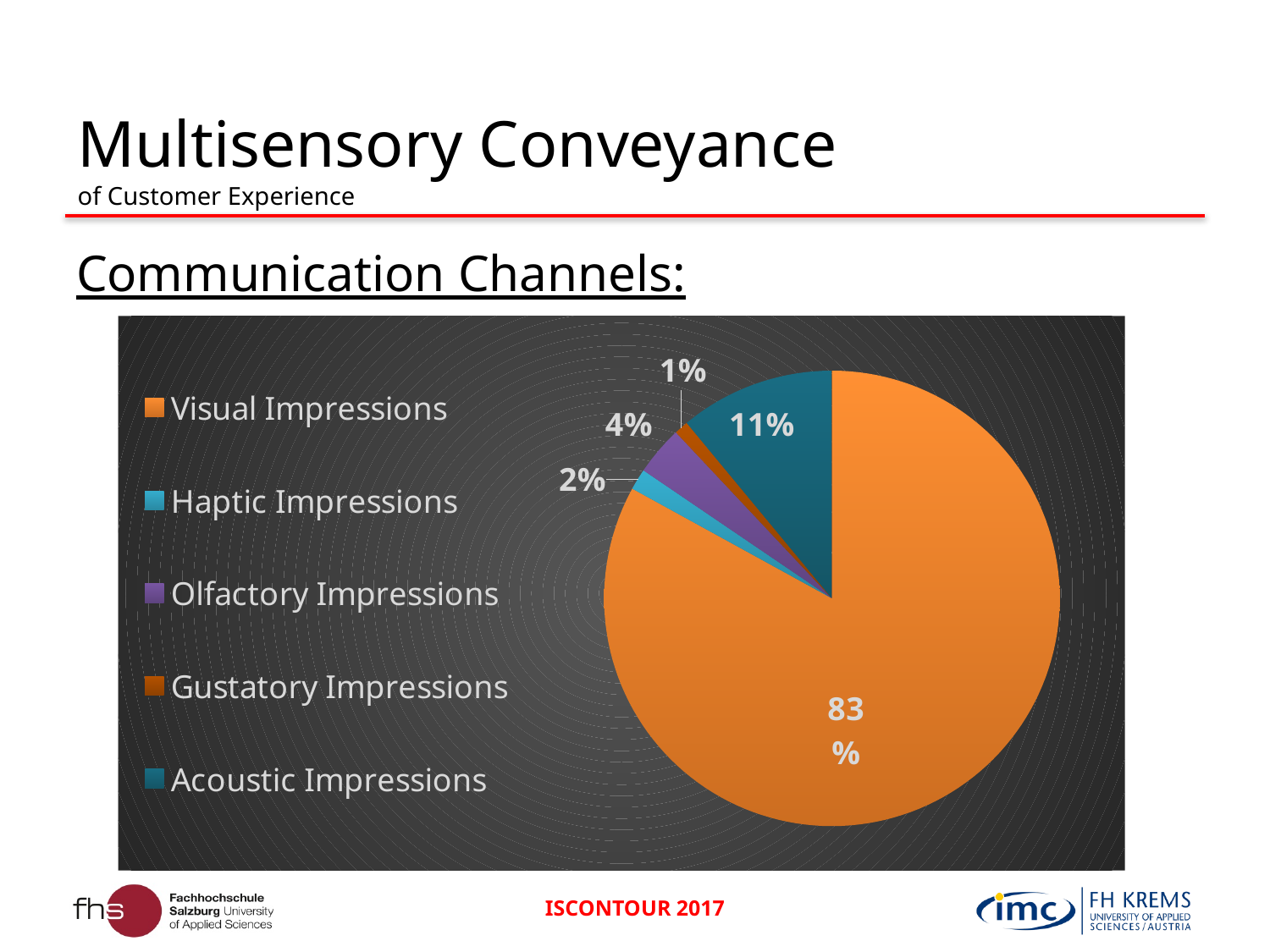
What is the value shown for Gustatory Impressions? 1% What colour is the slice for Visual Impressions? Orange Which is larger, the slice for Haptic Impressions or the slice for Olfactory Impressions? Olfactory Impressions What is the value shown for Haptic Impressions? 2% What kind of chart is shown on the slide? Pie chart Which communication channel has the smallest slice of the pie? Gustatory Impressions What share of the pie do Visual Impressions account for? 83% What is the difference in percentage points between Acoustic Impressions and Olfactory Impressions? 7 What is the value shown for Acoustic Impressions? 11% Which communication channel has the largest slice of the pie? Visual Impressions What is the value shown for Olfactory Impressions? 4% How many categories does the legend list? 5